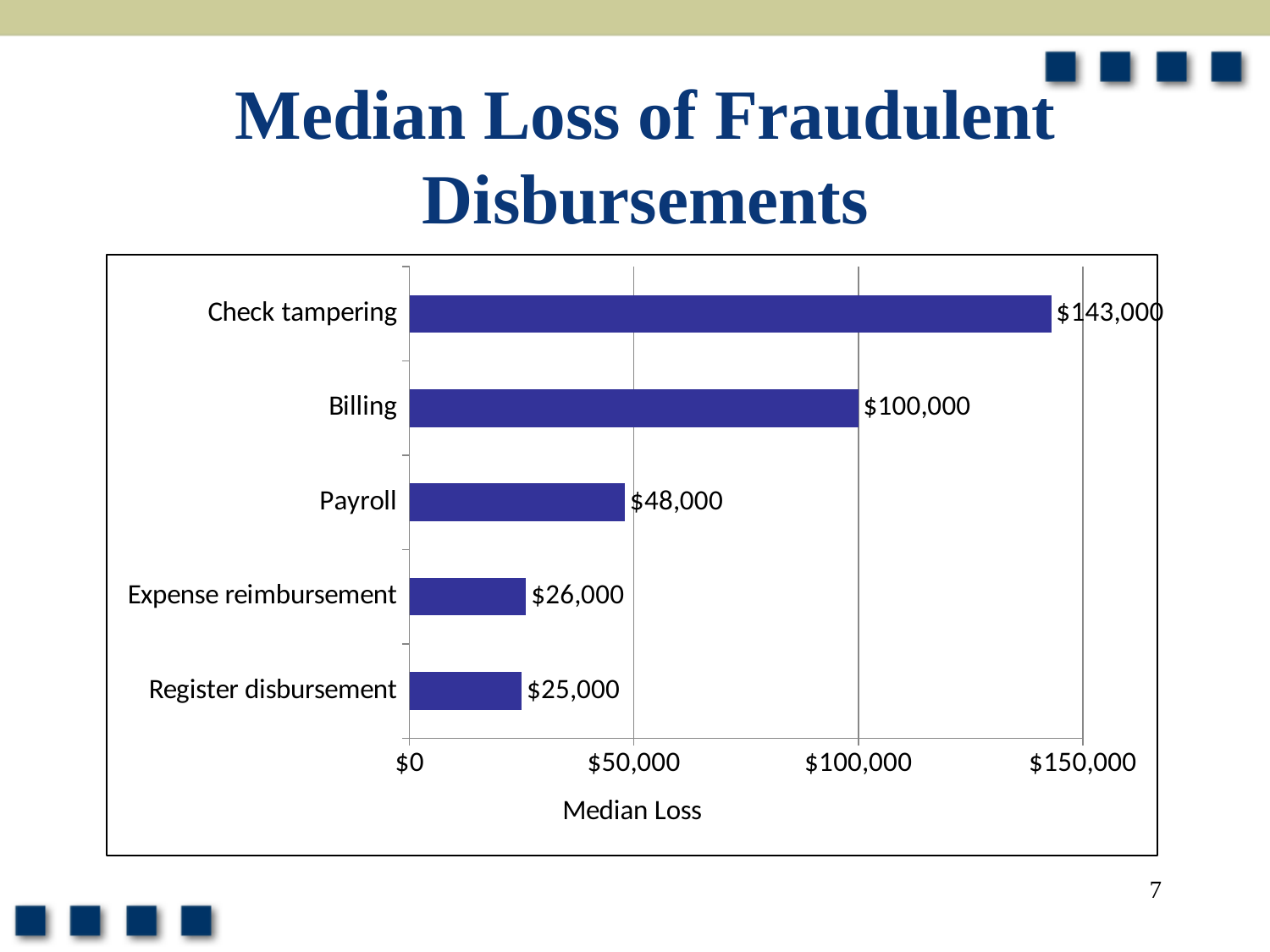
What is the median loss for Check tampering? $143,000 What is the median loss for Payroll? $48,000 Is the median loss for Billing greater or less than $50,000? greater Which category has the highest median loss? Check tampering What is the difference between the median loss for Check tampering and Billing? $43,000 What kind of chart is shown on the slide? Bar chart What is the label on the horizontal axis of the chart? Median Loss What is the difference between the median loss for Payroll and Expense reimbursement? $22,000 What is the median loss for Expense reimbursement? $26,000 Which category has the lowest median loss? Register disbursement Which has a larger median loss, Billing or Payroll? Billing How many categories are shown in the chart? 5